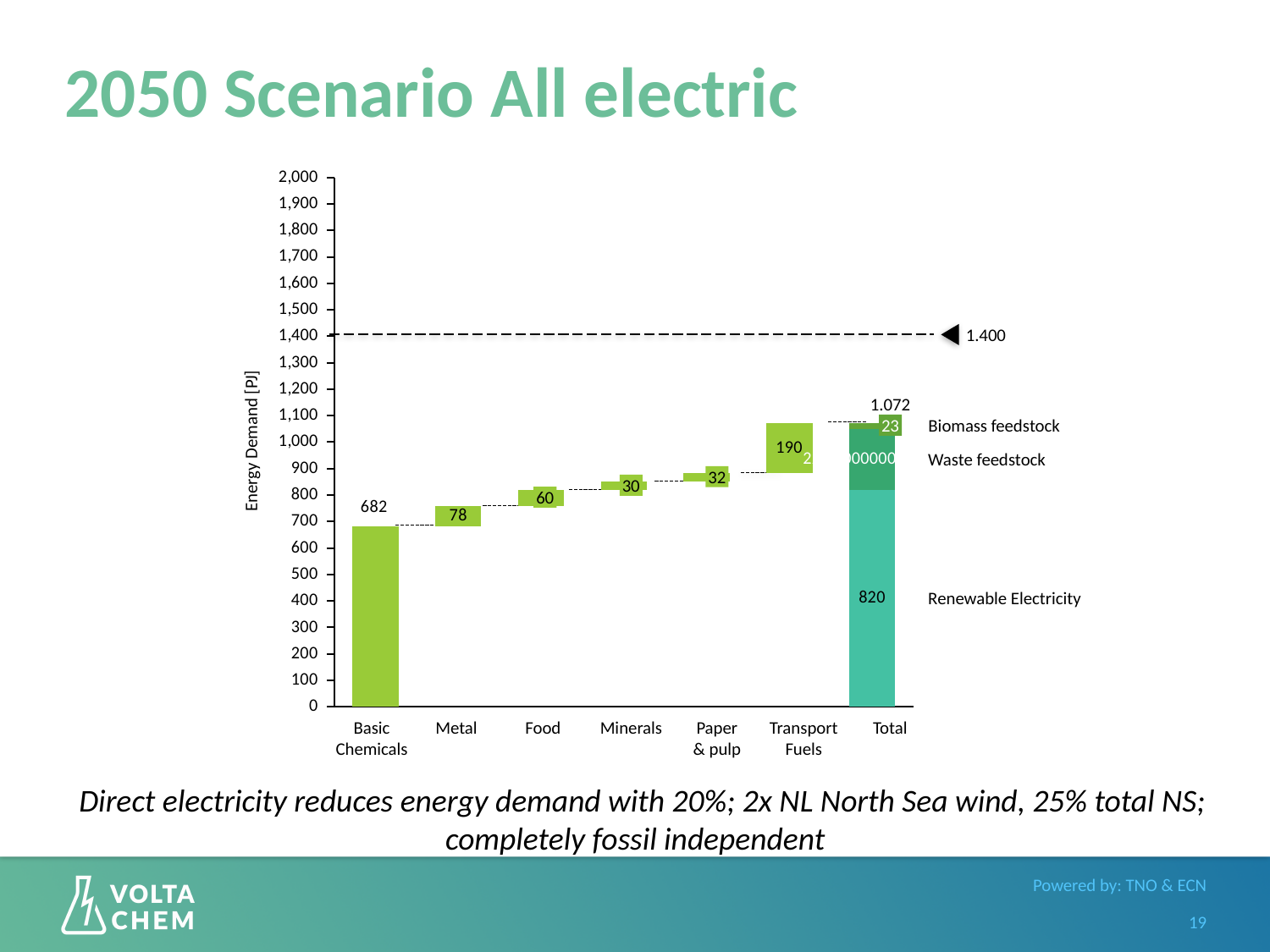
Which sector has the smallest value? Minerals What is the value labelled on the Total bar? 1.072 What is the Biomass feedstock value shown in the Total bar? 23 What is the value for Metal? 78 What is the value for Basic Chemicals? 682 How many categories are shown on the x axis? 7 What is the value for Transport Fuels? 190 Which is larger, the value for Metal or the value for Food? Metal What value does the dashed horizontal line mark? 1.400 What is the difference between the Basic Chemicals value and the Transport Fuels value? 492 Which sector has the largest value? Basic Chemicals What is the Renewable Electricity value shown in the Total bar? 820